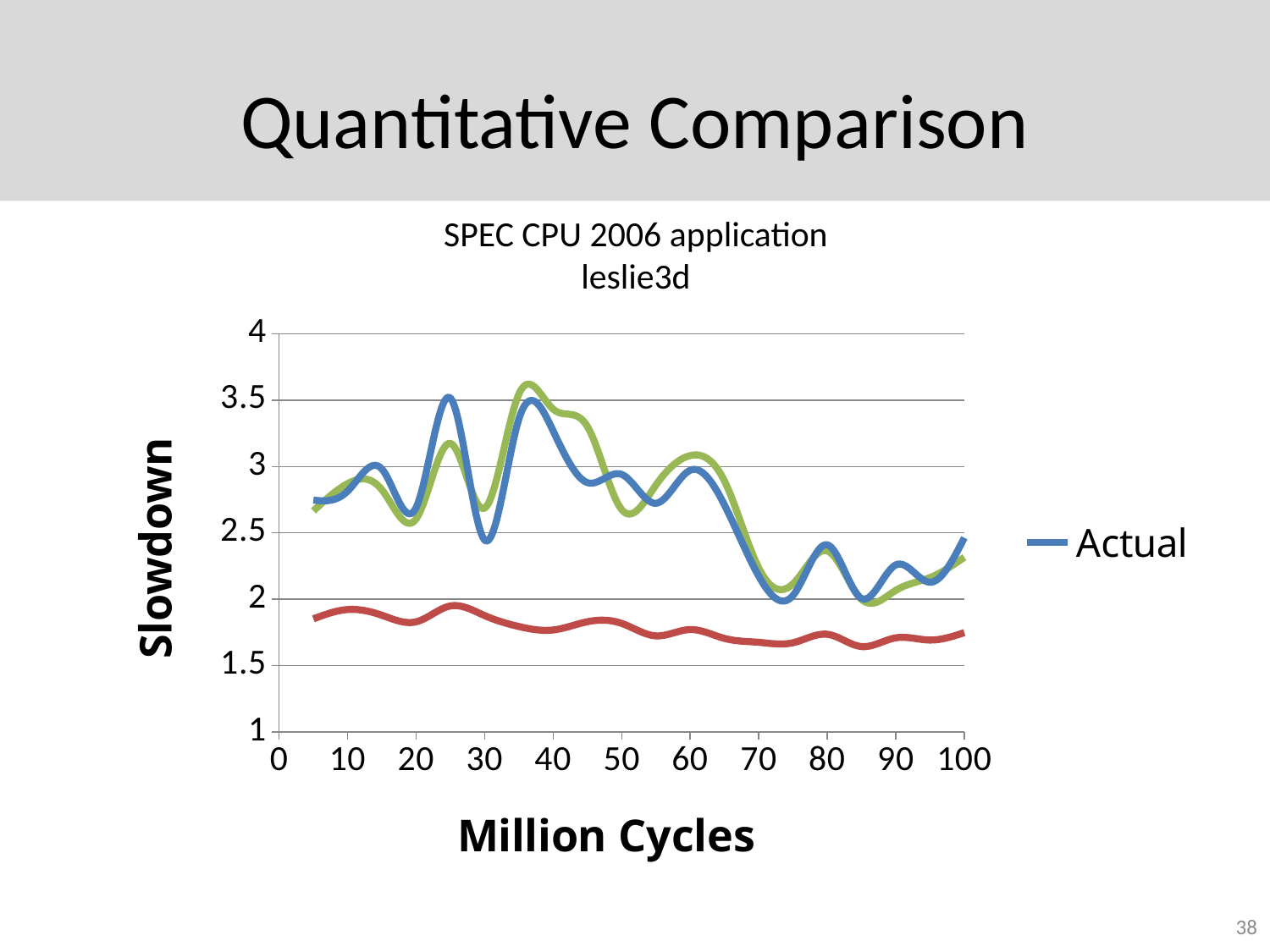
What is the title of the chart? SPEC CPU 2006 application leslie3d Which line stays lowest across the whole x axis? the red line At 50 million cycles, which is larger: the Actual line or the red line? Actual What is the name of the series listed in the legend? Actual Does the red line rise or fall overall from 0 to 100 million cycles? fall What kind of chart is shown on the slide? line chart Is the value of the Actual line at 40 million cycles greater or less than 3? greater Is the value of the red line at 100 million cycles greater or less than 2? less How many lines are plotted on the chart? 3 Is the value of the red line at 10 million cycles greater or less than 2? less How many series does the legend list? 1